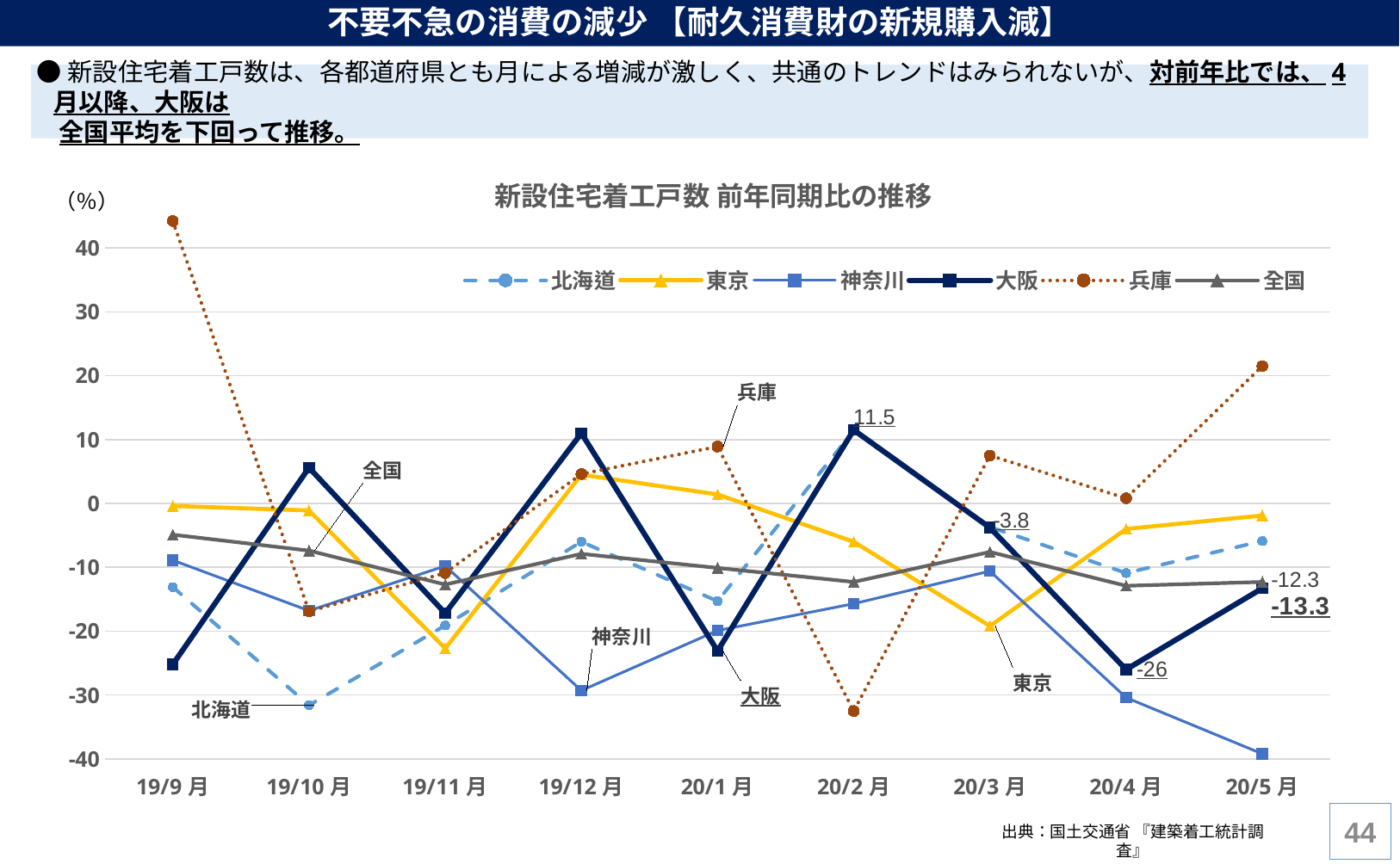
What is the difference between the 大阪 values in 20/2月 and 20/4月? 37.5 Which series has the highest value in 20/5月? 兵庫 What is the value for 大阪 in 20/4月? -26 What is the value for 全国 in 20/5月? -12.3 Does the 大阪 line rise or fall from 20/2月 to 20/4月? fall Is the value for 兵庫 in 19/9月 greater or less than 40? greater How many series does the legend list? 6 What is the value for 大阪 in 20/5月? -13.3 In 20/5月, which is higher, 大阪 or 全国? 全国 What is the value for 大阪 in 20/2月? 11.5 What kind of chart is shown on the slide? line chart How many months are shown on the x axis? 9